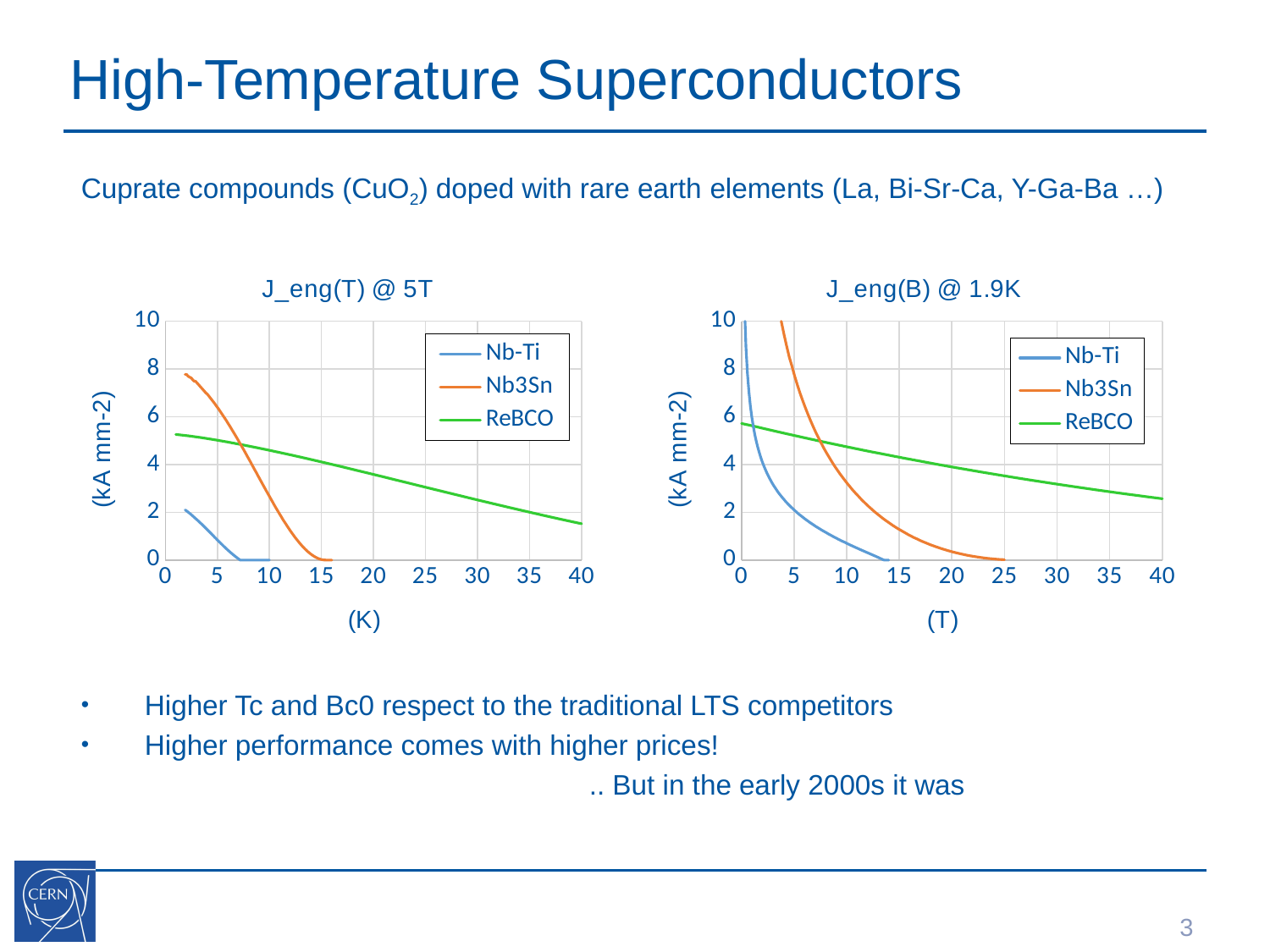
In the left chart (J_eng(T) @ 5T), which series has the higher value at 20 K, ReBCO or Nb3Sn? ReBCO In the left chart (J_eng(T) @ 5T), is the Nb3Sn value at 5 K greater or less than 4? greater In the right chart (J_eng(B) @ 1.9K), which series are listed in the legend? Nb-Ti, Nb3Sn, ReBCO In the right chart (J_eng(B) @ 1.9K), does the Nb-Ti line rise or fall as the field increases along the x axis? fall In the right chart (J_eng(B) @ 1.9K), which series has the higher value at 30 T, ReBCO or Nb3Sn? ReBCO In the left chart (J_eng(T) @ 5T), does the ReBCO line rise or fall as temperature increases along the x axis? fall How many series does the legend of the left chart (J_eng(T) @ 5T) list? 3 In the right chart (J_eng(B) @ 1.9K), is the Nb-Ti value at 5 T greater or less than 4? less What is the y-axis label of the right chart (J_eng(B) @ 1.9K)? (kA mm-2) In the left chart (J_eng(T) @ 5T), is the ReBCO value at 40 K greater or less than 2? less What kind of chart is the left chart titled J_eng(T) @ 5T? line chart